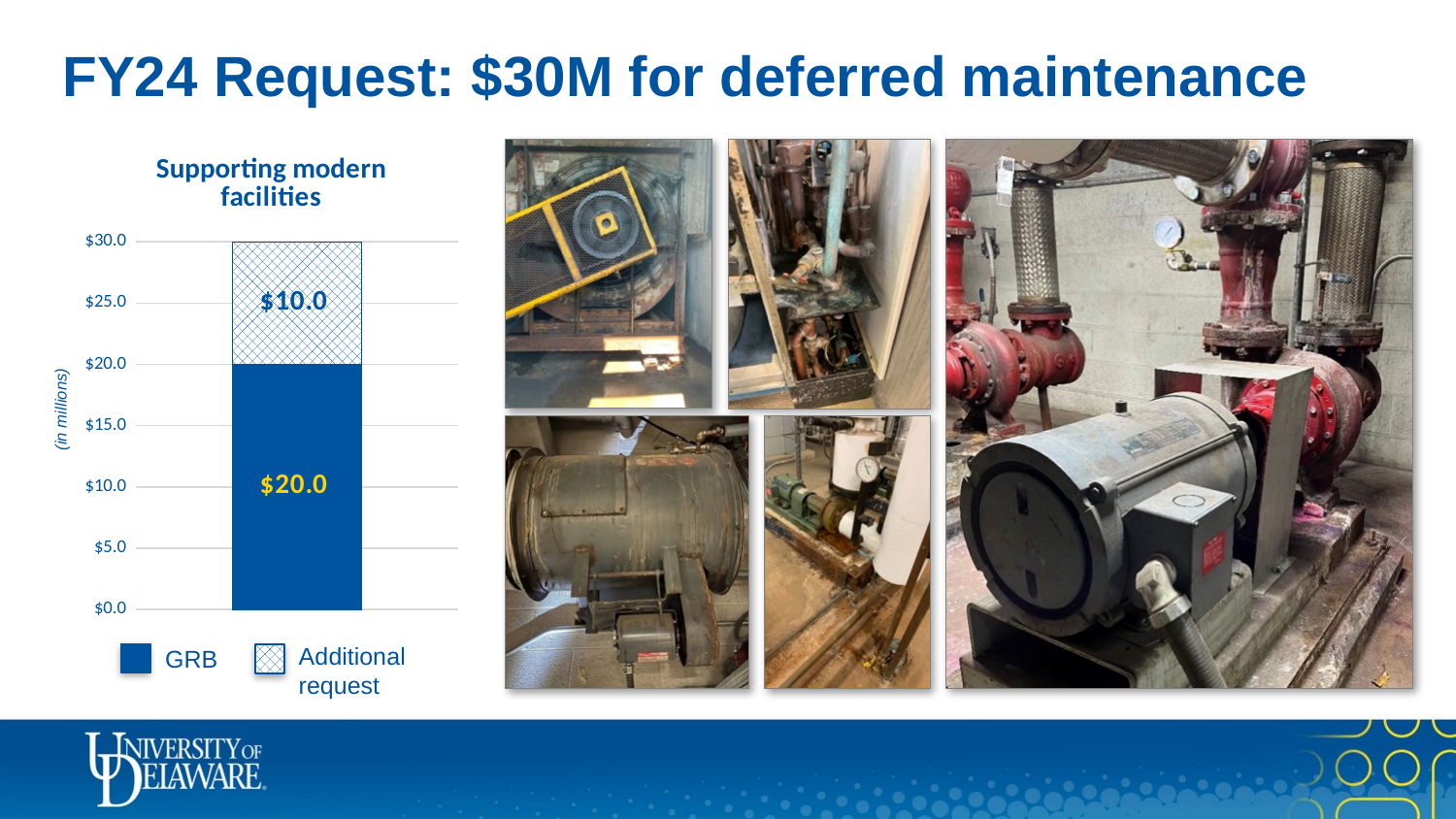
Which series has the smallest value in the bar? Additional request What is the title of the chart? Supporting modern facilities Is the GRB segment value greater or less than $15.0? greater What is the difference between the GRB segment and the Additional request segment? $10.0 What is the value of the GRB segment in the stacked bar? $20.0 What unit is indicated on the vertical axis label of the chart? in millions Which series has the largest value in the bar? GRB What kind of chart is shown on the slide? Stacked bar chart Which segment is larger, GRB or Additional request? GRB How many series does the legend list? 2 What is the total of the stacked bar? $30.0 What is the value of the Additional request segment in the stacked bar? $10.0